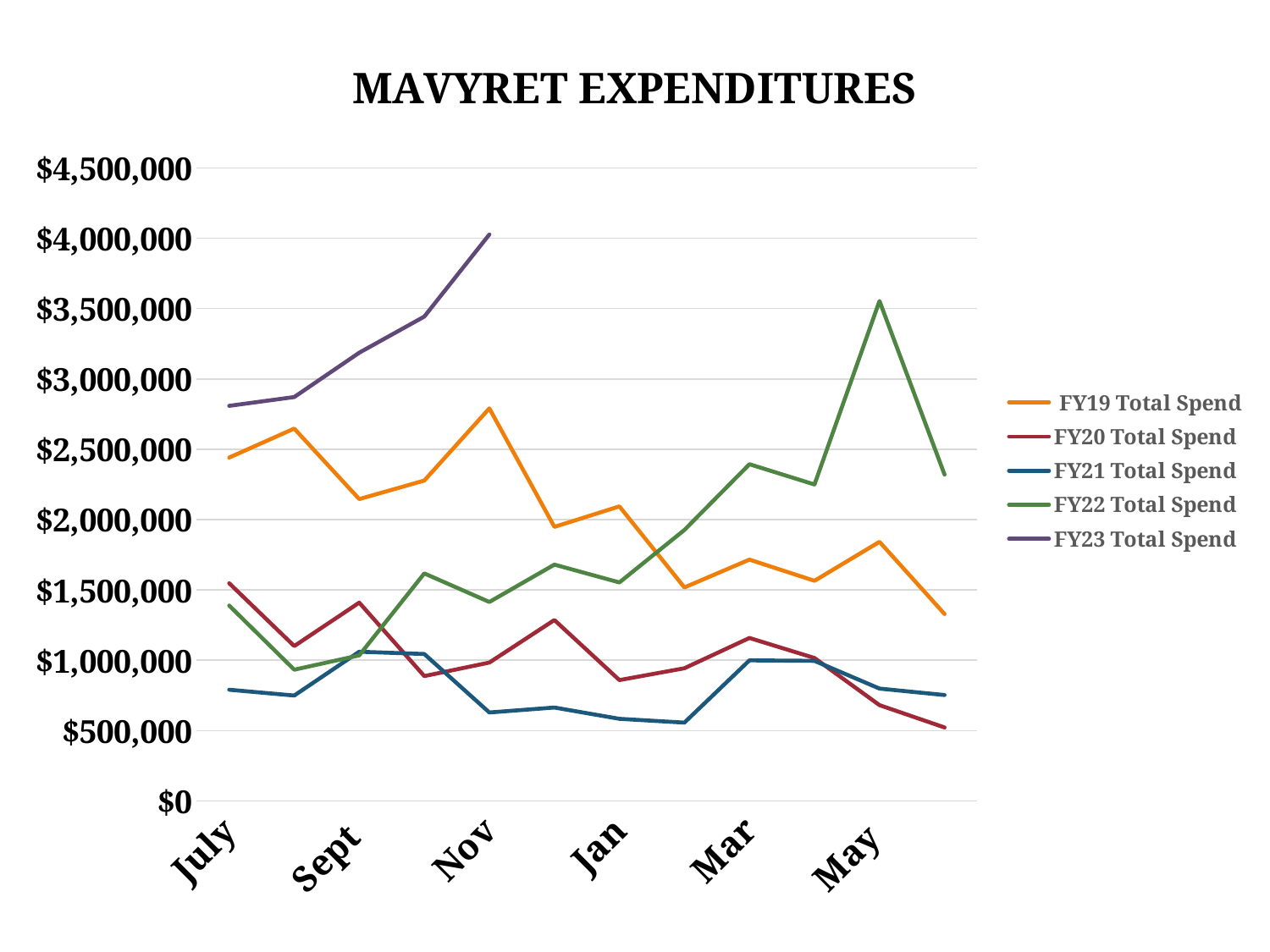
Does the FY23 Total Spend line rise or fall from July to Nov? rise Which series has the lowest value in July? FY21 Total Spend What kind of chart is shown on the slide? line chart Which is larger in May, FY22 Total Spend or FY19 Total Spend? FY22 Total Spend Is the value for FY23 Total Spend in July greater or less than $2,500,000? greater Is the value for FY22 Total Spend in May greater or less than $3,000,000? greater Which is larger in July, FY19 Total Spend or FY20 Total Spend? FY19 Total Spend Which series has the highest value in July? FY23 Total Spend How many series does the legend list? 5 What is the title of the chart? MAVYRET EXPENDITURES Which series is plotted in purple? FY23 Total Spend Is the value for FY21 Total Spend in July greater or less than $1,000,000? less